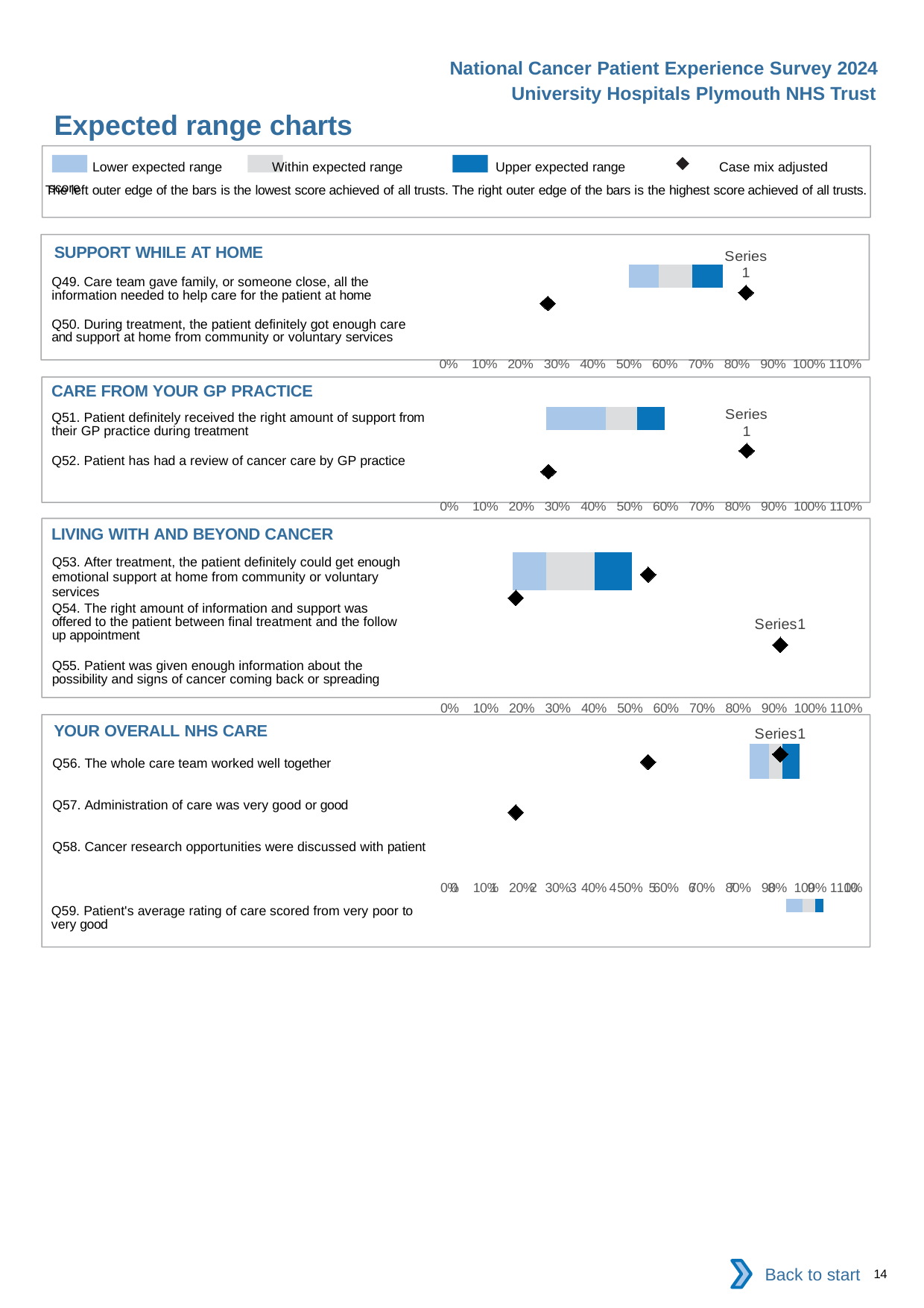
How many questions are listed in the LIVING WITH AND BEYOND CANCER chart? 3 In the CARE FROM YOUR GP PRACTICE chart, does the right edge of the expected range bar for Q51 lie above or below 70%? below How many questions are listed in the YOUR OVERALL NHS CARE chart? 4 What is the highest tick label shown on the x axis of the SUPPORT WHILE AT HOME chart? 110% In the YOUR OVERALL NHS CARE chart, is the case mix adjusted score plotted in the Q57 row greater or less than 50%? less How many entries does the legend at the top of the slide list? 4 How many chart sections (question groups) are shown on the slide? 4 In the YOUR OVERALL NHS CARE chart, is the case mix adjusted score plotted in the Q56 row greater or less than 40%? greater What kind of chart is used on this slide to show the expected ranges? bar chart Which legend entry is shown with a black diamond marker? Case mix adjusted score Which legend entry is shown in dark blue? Upper expected range